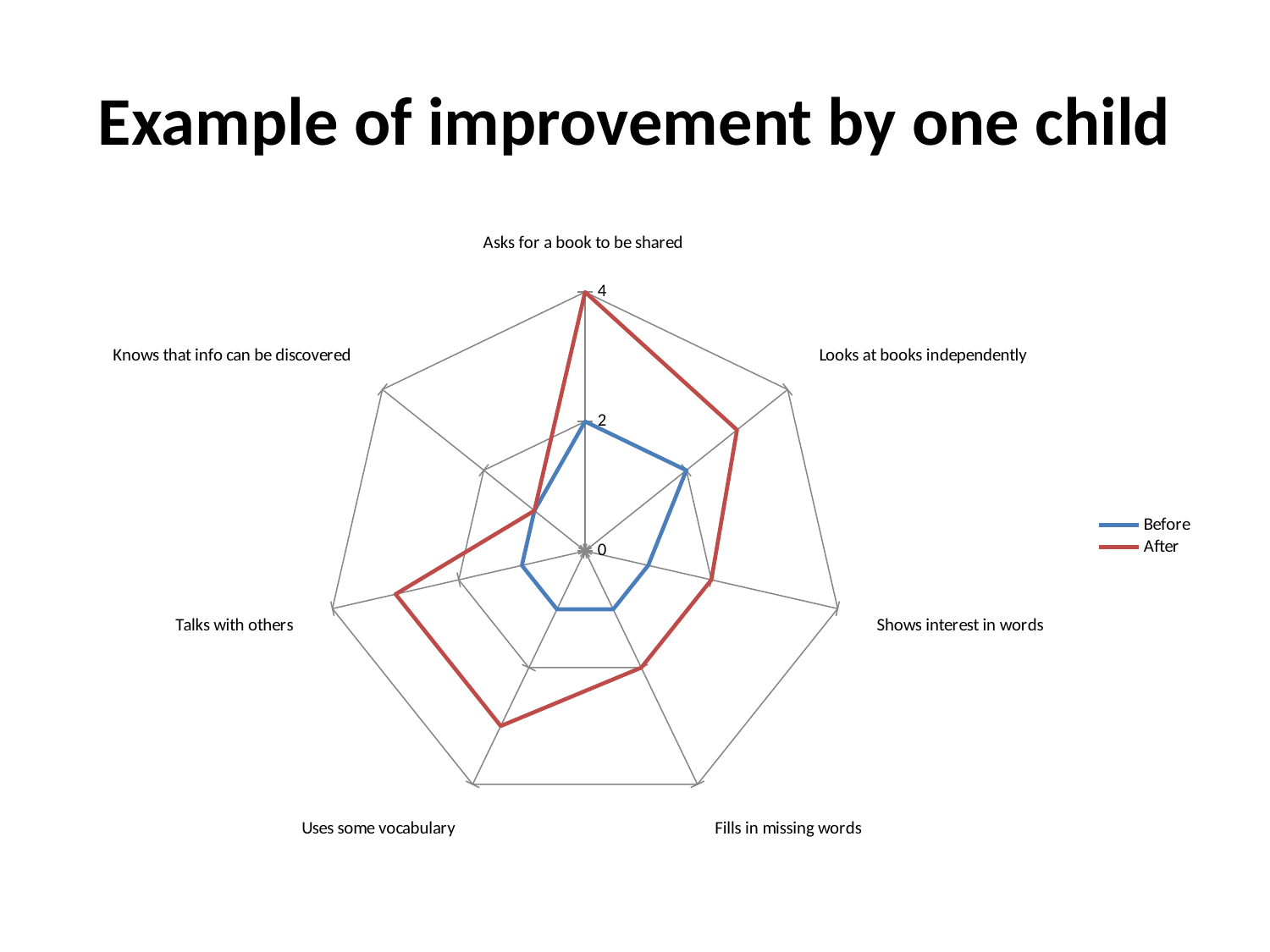
Which category has the lowest After value? Knows that info can be discovered Is the Before value for 'Talks with others' greater or less than 2? less What kind of chart is shown on the slide? Radar chart How many categories (axes) does the radar chart have? 7 Which category has the highest After value? Asks for a book to be shared What is the Before value for 'Asks for a book to be shared'? 2 Is the After value for 'Uses some vocabulary' greater or less than 2? greater For 'Asks for a book to be shared', which is larger, the Before value or the After value? After What is the After value for 'Asks for a book to be shared'? 4 How many series does the legend list? 2 By how much did the value for 'Asks for a book to be shared' increase from Before to After? 2 Which colour represents the After series in the legend? Red